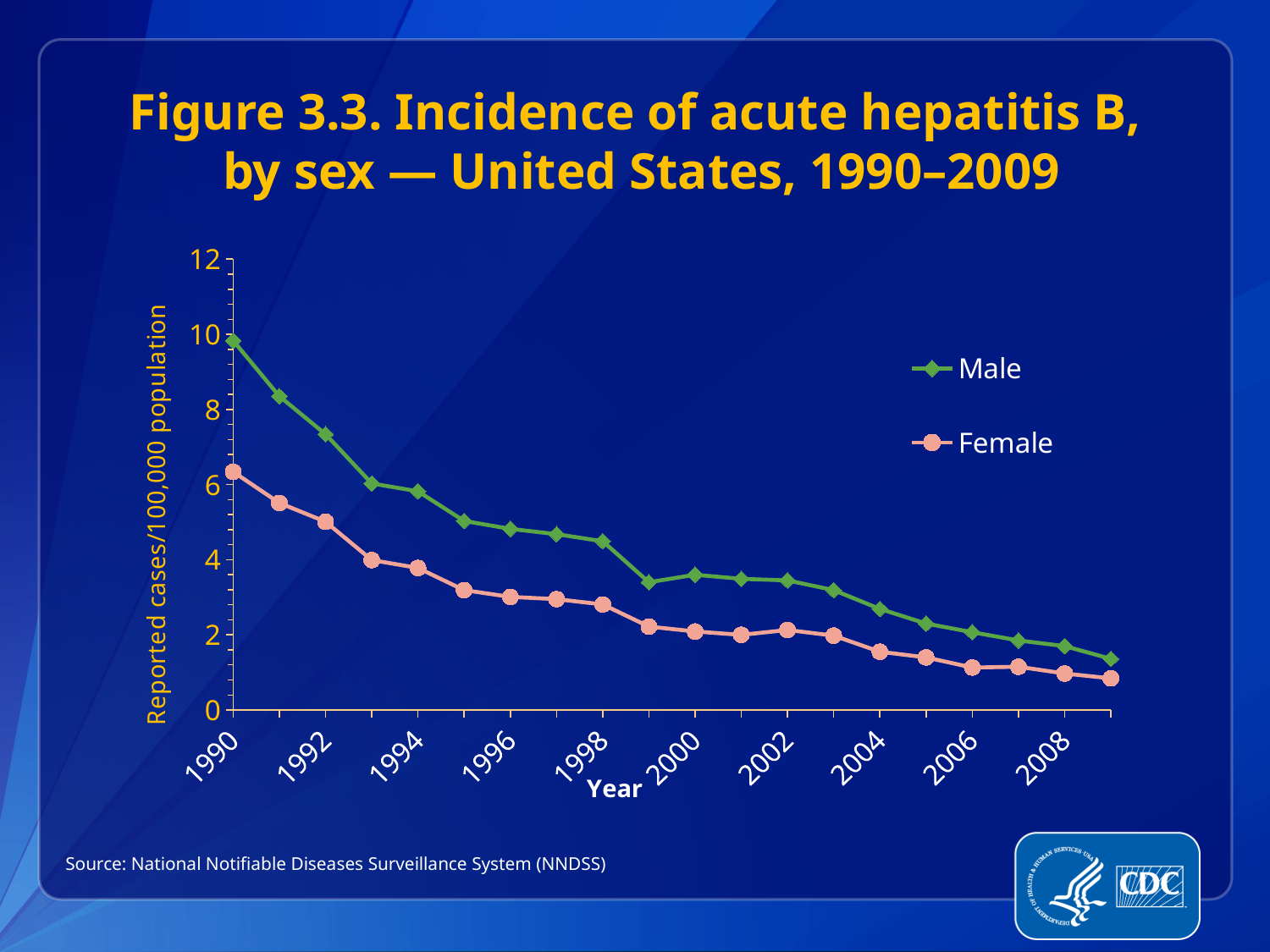
Which two series are shown in the legend? Male and Female In 1990, which is larger, the Male value or the Female value? Male What is the label of the y axis? Reported cases/100,000 population In which year is the Female value lowest? 2009 How many series does the legend list? 2 Do the Female values rise or fall from 1990 to 2009? Fall In which year is the Male value highest? 1990 Is the Male value for 1993 greater or less than 4? greater Is the Female value for 2009 greater or less than 2? less What kind of chart is shown on the slide? Line chart Do the Male values rise or fall from 1990 to 2009? Fall Is the Male value for 1990 greater or less than 8? greater